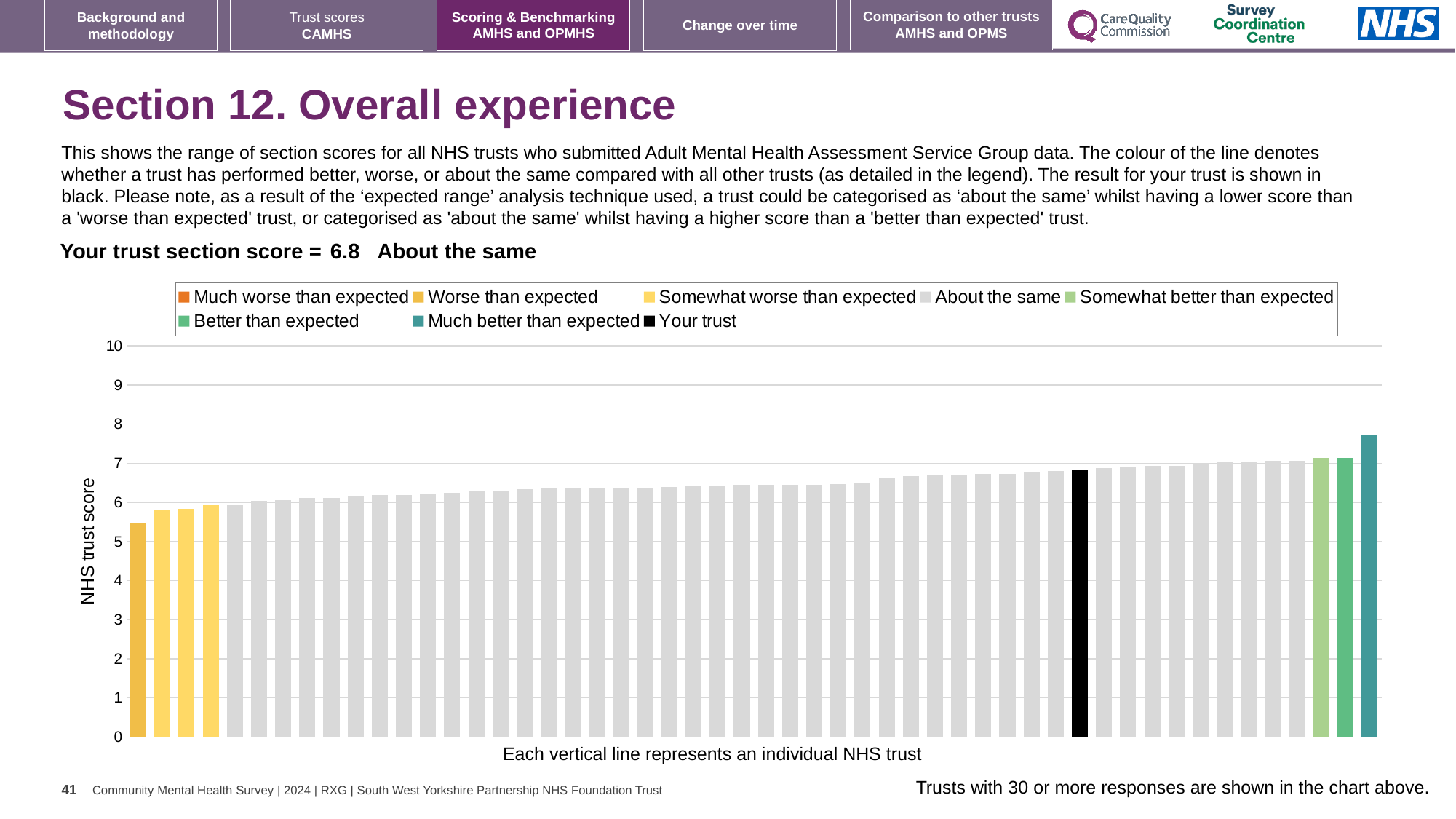
What is the label on the vertical axis of the chart? NHS trust score Is the value of the lowest bar in the chart greater or less than 6? less What is the section score for your trust shown on the slide? 6.8 How many entries does the chart legend list? 8 What kind of chart is shown on the slide? bar chart Is the value for your trust greater or less than 7? less Is the value of the highest bar in the chart greater or less than 7? greater Which category does your trust's section score fall into, according to the slide? About the same How many bars are coloured as 'Worse than expected'? 1 What colour is the bar representing your trust? black Do the bar values rise or fall from left to right along the x axis? rise Which legend category does the tallest bar in the chart belong to? Much better than expected